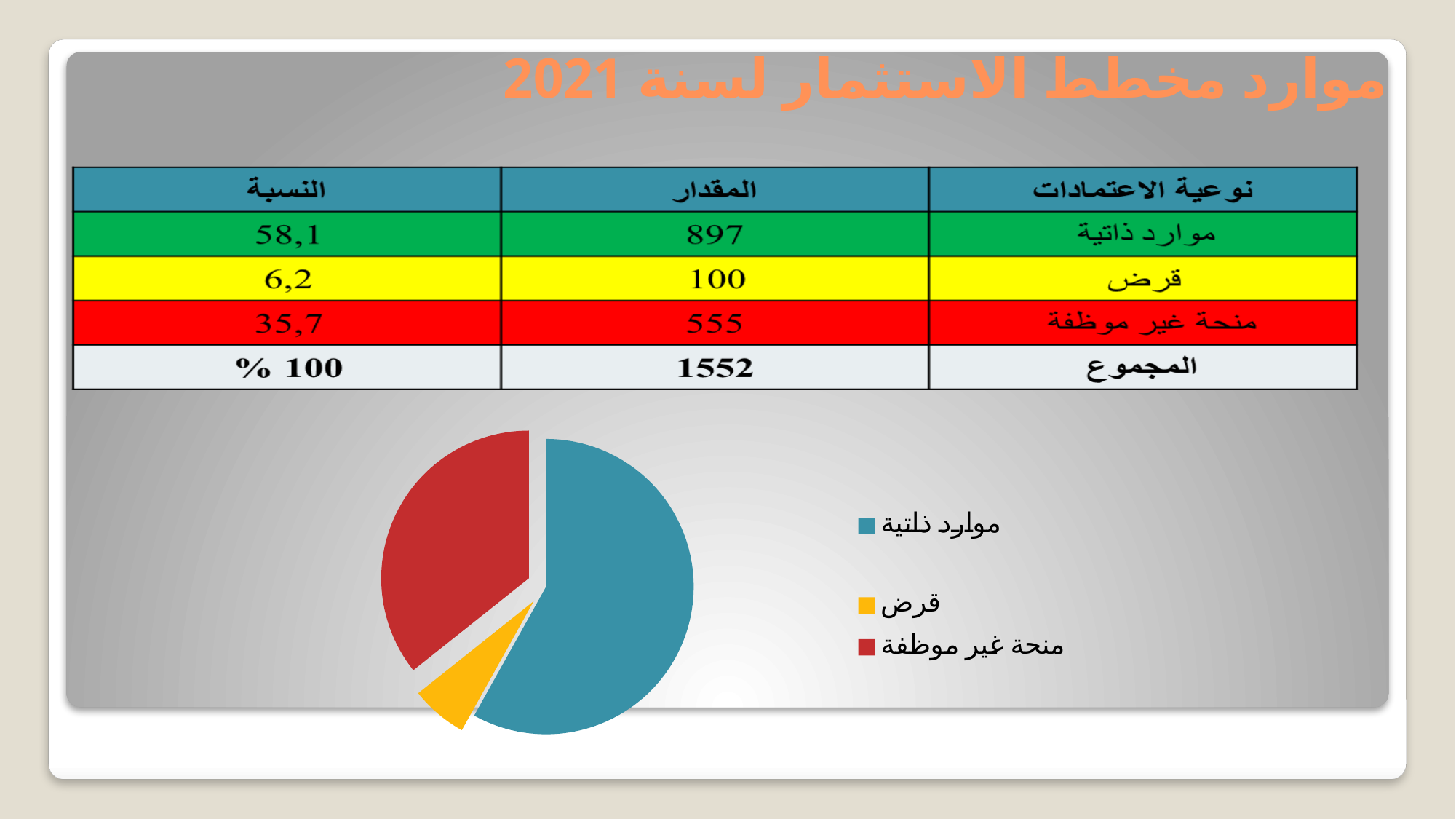
What kind of chart is shown on the slide? pie chart According to the table on the slide, what is the amount (المقدار) for موارد ذاتية? 897 According to the table on the slide, what is the amount (المقدار) for منحة غير موظفة? 555 How many entries does the pie chart's legend list? 3 According to the table on the slide, what is the difference between the amounts for موارد ذاتية and منحة غير موظفة? 342 According to the table on the slide, what share (النسبة) does قرض represent? 6,2 According to the table on the slide, what is the total (المجموع) of the amounts? 1552 Which category has the largest slice in the pie chart? موارد ذاتية What colour is the slice for قرض in the pie chart? orange Which slice is larger in the pie chart, منحة غير موظفة or قرض? منحة غير موظفة How many slices does the pie chart have? 3 Which category has the smallest slice in the pie chart? قرض